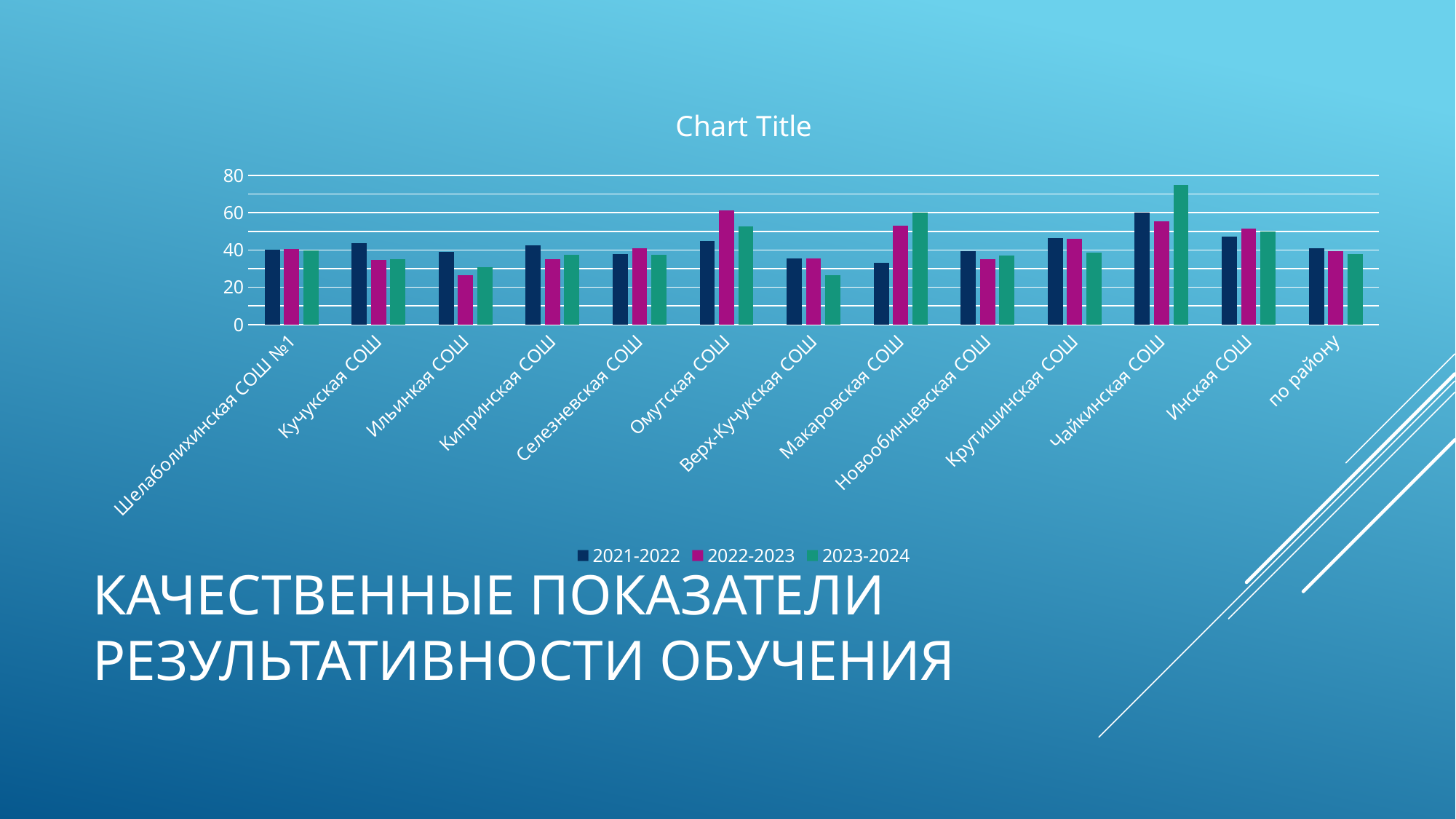
For Омутская СОШ, which series has the larger value: 2021-2022 or 2022-2023? 2022-2023 How many series does the chart legend list? 3 Which category has the highest value for the 2023-2024 series? Чайкинская СОШ Which category has the lowest value for the 2022-2023 series? Ильинкая СОШ For Макаровская СОШ, which series has the larger value: 2021-2022 or 2023-2024? 2023-2024 Is the 2021-2022 value for Макаровская СОШ greater or less than 40? less Is the 2023-2024 value for Чайкинская СОШ greater or less than 60? greater What title is displayed above the chart? Chart Title Which category has the highest value for the 2022-2023 series? Омутская СОШ Is the 2022-2023 value for Омутская СОШ greater or less than 50? greater What kind of chart is shown on the slide? bar chart How many categories are shown along the x axis of the chart? 13